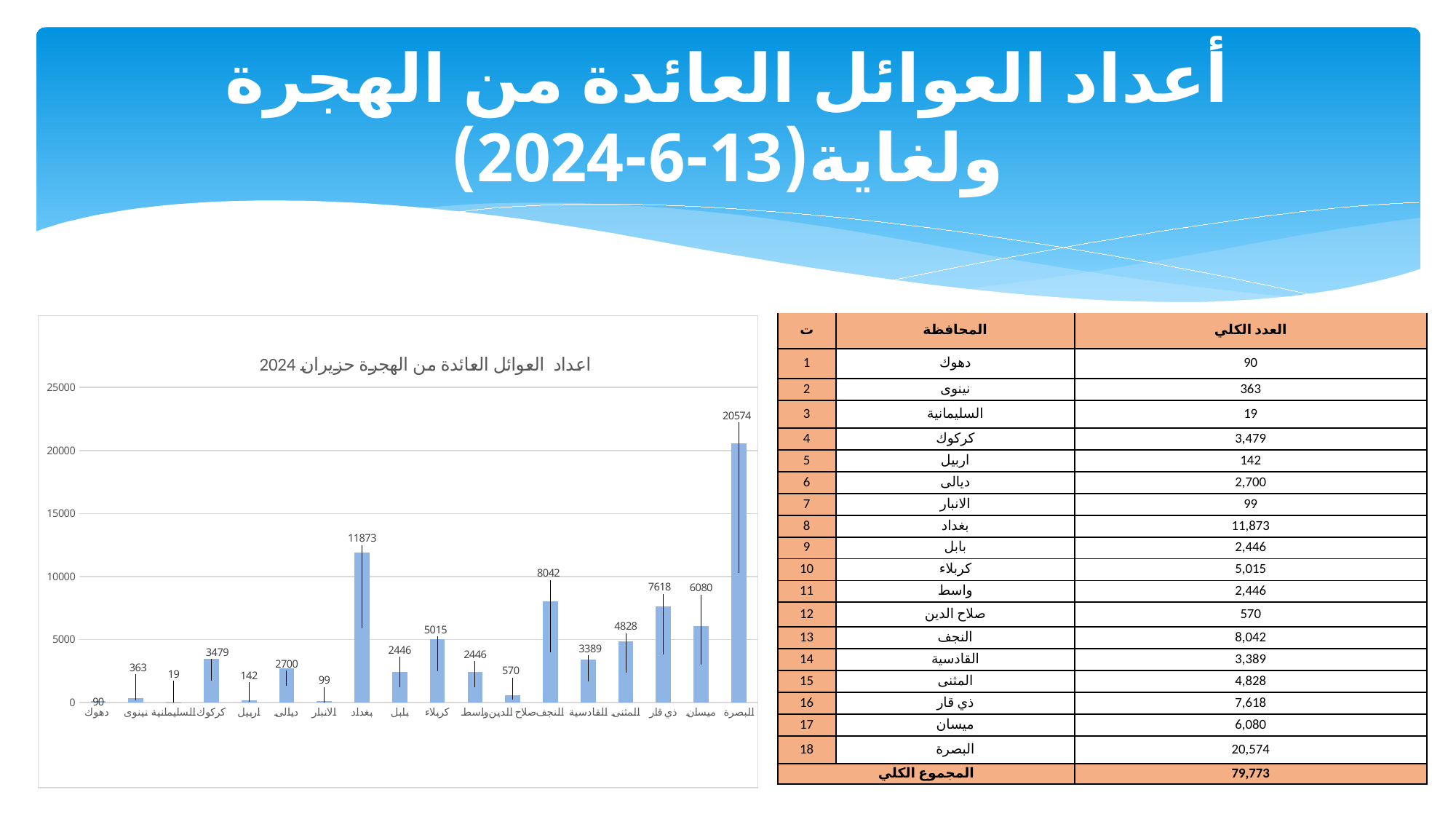
Is the value for النجف greater or less than 5000? greater What is the value for النجف in the bar chart? 8042 Which category has the highest value in the bar chart? البصرة What kind of chart is shown on the slide? bar chart Which category has the lowest value in the bar chart? السليمانية What is the title of the chart? اعداد العوائل العائدة من الهجرة حزيران 2024 How many categories are shown in the bar chart? 18 What is the difference between the values for ذي قار and ميسان? 1538 What is the value for البصرة in the bar chart? 20574 What is the value for بغداد in the bar chart? 11873 What is the difference between the values for البصرة and بغداد? 8701 Which is larger, the value for كربلاء or the value for المثنى? كربلاء